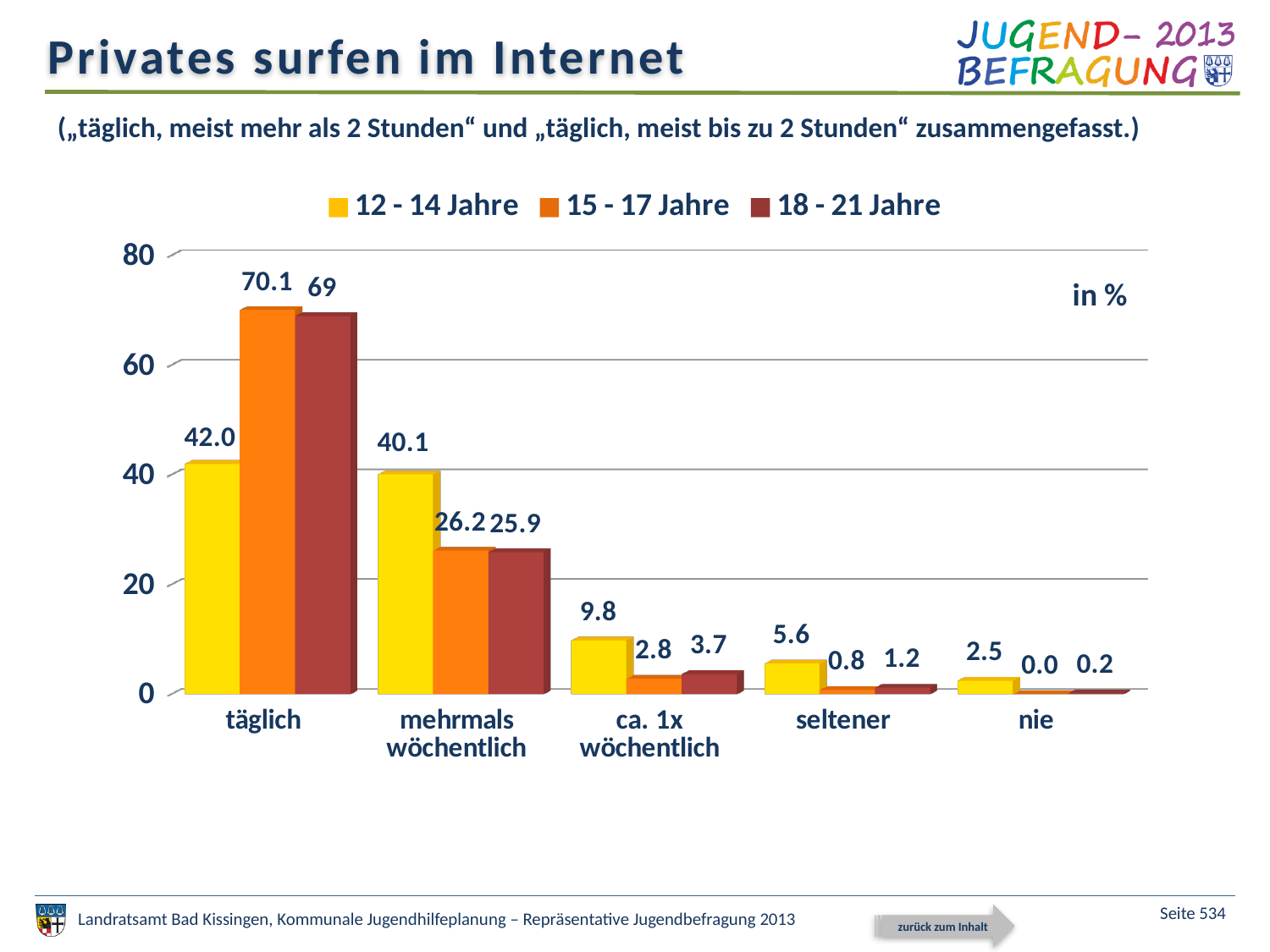
What is the value for the 15 - 17 Jahre series in the nie category? 0.0 What is the value for the 18 - 21 Jahre series in the mehrmals wöchentlich category? 25.9 What kind of chart is shown on the slide? bar chart What is the difference between the 15 - 17 Jahre and 12 - 14 Jahre values in the täglich category? 28.1 What is the value for the 12 - 14 Jahre series in the täglich category? 42.0 In the mehrmals wöchentlich category, which series has the larger value: 12 - 14 Jahre or 15 - 17 Jahre? 12 - 14 Jahre Which category has the lowest value for the 18 - 21 Jahre series? nie What unit is indicated for the values in the chart? in % What is the value for the 15 - 17 Jahre series in the täglich category? 70.1 Which category has the highest value for the 12 - 14 Jahre series? täglich How many categories are shown on the x axis? 5 How many series does the legend list? 3